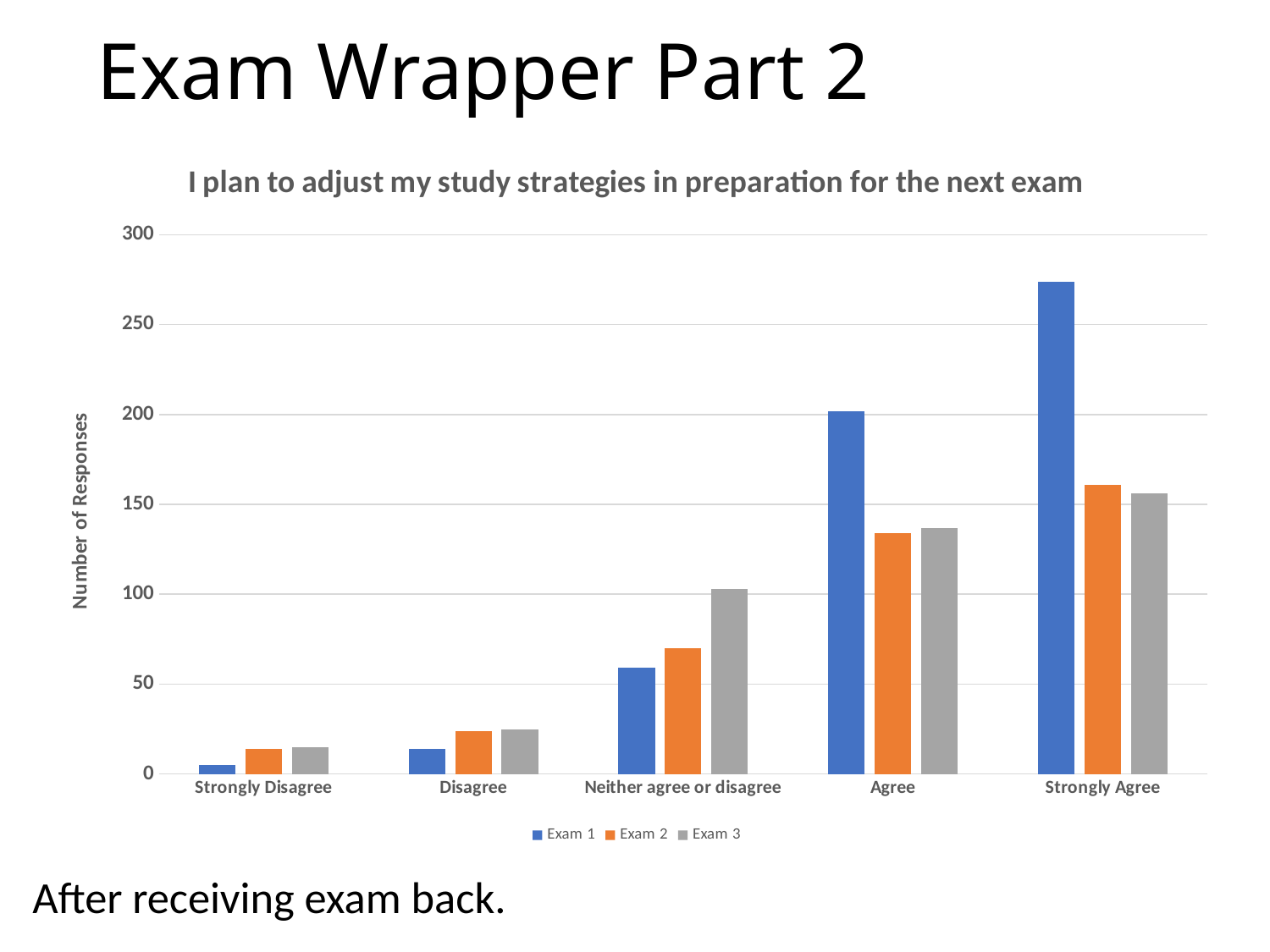
Do the Exam 1 values rise or fall moving from Strongly Disagree to Strongly Agree along the x axis? rise For Exam 1, which response category has the lowest number of responses? Strongly Disagree For Exam 1, which response category has the highest number of responses? Strongly Agree What type of chart is shown on the slide? Bar chart How many series does the legend list? 3 For the Neither agree or disagree category, which is larger: the Exam 1 value or the Exam 3 value? Exam 3 What is the label of the vertical axis? Number of Responses Is the Exam 1 value for Strongly Agree greater or less than 250? greater For the Agree category, which is larger: the Exam 1 value or the Exam 2 value? Exam 1 Is the Exam 1 value for Neither agree or disagree greater or less than 100? less Is the Exam 2 value for Agree greater or less than 150? less How many response categories are shown on the x axis? 5